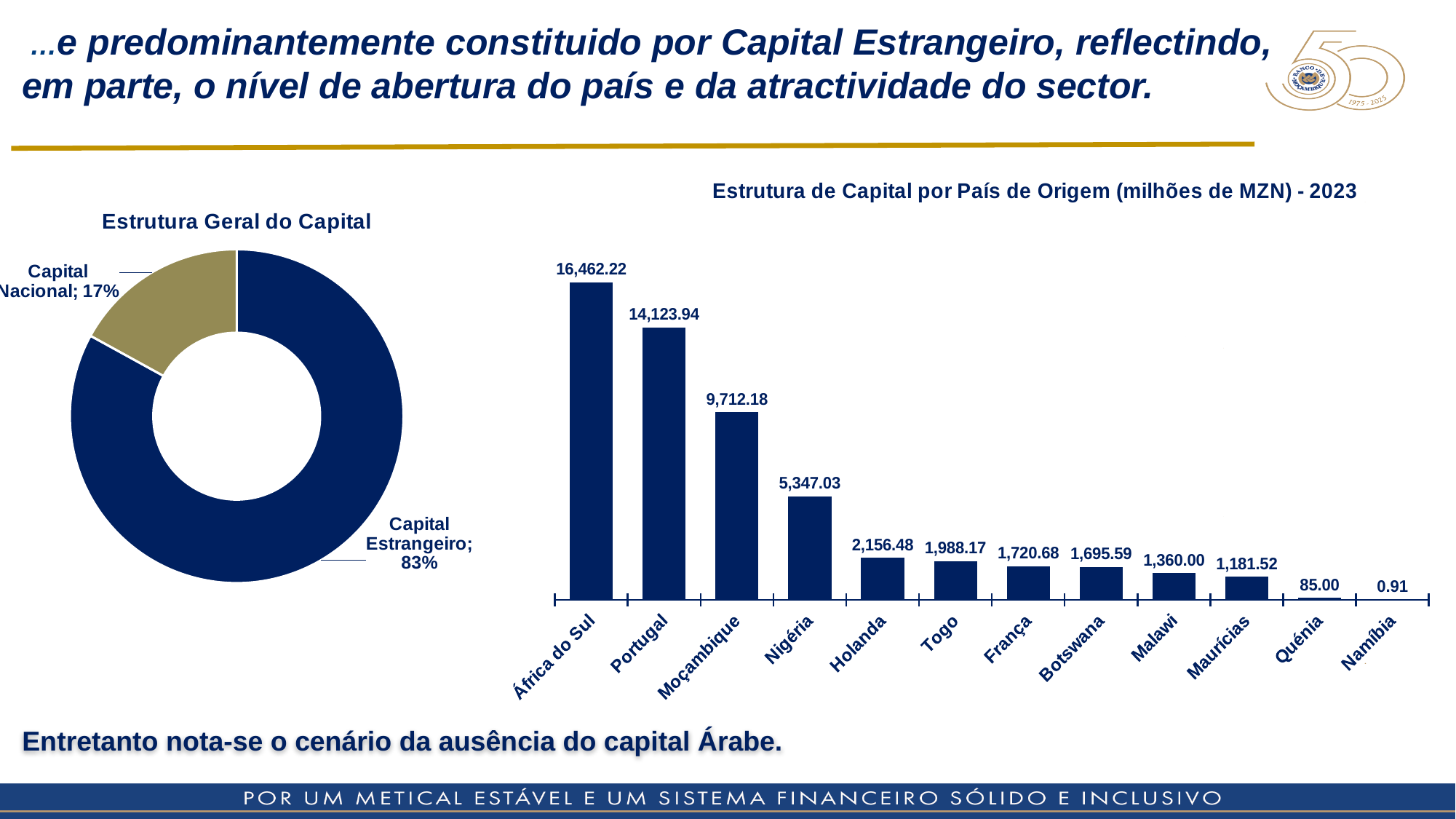
What kind of chart is 'Estrutura Geral do Capital'? Pie (donut) chart What kind of chart is 'Estrutura de Capital por País de Origem (milhões de MZN) - 2023'? Bar chart In the chart 'Estrutura de Capital por País de Origem (milhões de MZN) - 2023', what is the value for Moçambique? 9,712.18 In the chart 'Estrutura Geral do Capital', what share is Capital Nacional? 17% In the chart 'Estrutura de Capital por País de Origem (milhões de MZN) - 2023', which is larger, Holanda or Togo? Holanda In the chart 'Estrutura de Capital por País de Origem (milhões de MZN) - 2023', which country has the highest value? África do Sul In the chart 'Estrutura de Capital por País de Origem (milhões de MZN) - 2023', what is the value for Portugal? 14,123.94 In the chart 'Estrutura de Capital por País de Origem (milhões de MZN) - 2023', which country has the lowest value? Namíbia How many countries are shown in the chart 'Estrutura de Capital por País de Origem (milhões de MZN) - 2023'? 12 In the chart 'Estrutura de Capital por País de Origem (milhões de MZN) - 2023', what is the difference between África do Sul and Portugal? 2,338.28 In the chart 'Estrutura Geral do Capital', what share is Capital Estrangeiro? 83% In the chart 'Estrutura de Capital por País de Origem (milhões de MZN) - 2023', what is the value for Quénia? 85.00